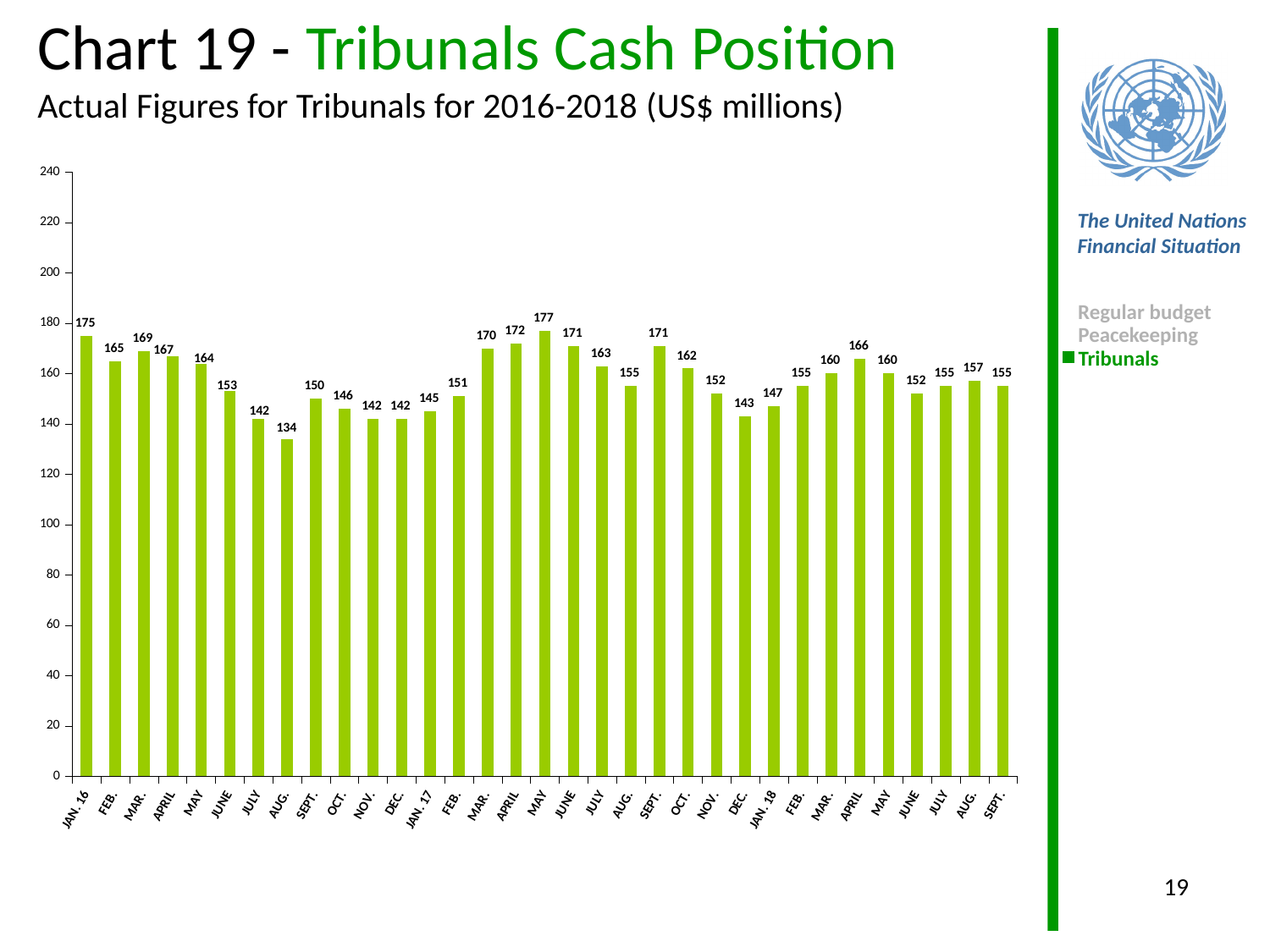
What is the subtitle of the chart below the main title? Actual Figures for Tribunals for 2016-2018 (US$ millions) What is the value for the last bar, September 2018? 155 What kind of chart is shown on the slide? bar chart What is the difference between January 2016 and January 2017? 30 What is the difference between the highest value (May 2017) and the lowest value (August 2016)? 43 Which month has the lowest value? August 2016 Is the value for August 2016 greater or less than 140? less Which month has the highest value? May 2017 Which is larger, the value for April 2017 or the value for April 2018? April 2017 What is the value for May 2017? 177 How many bars are plotted in the chart? 33 What is the value for January 2016 (JAN. 16)? 175